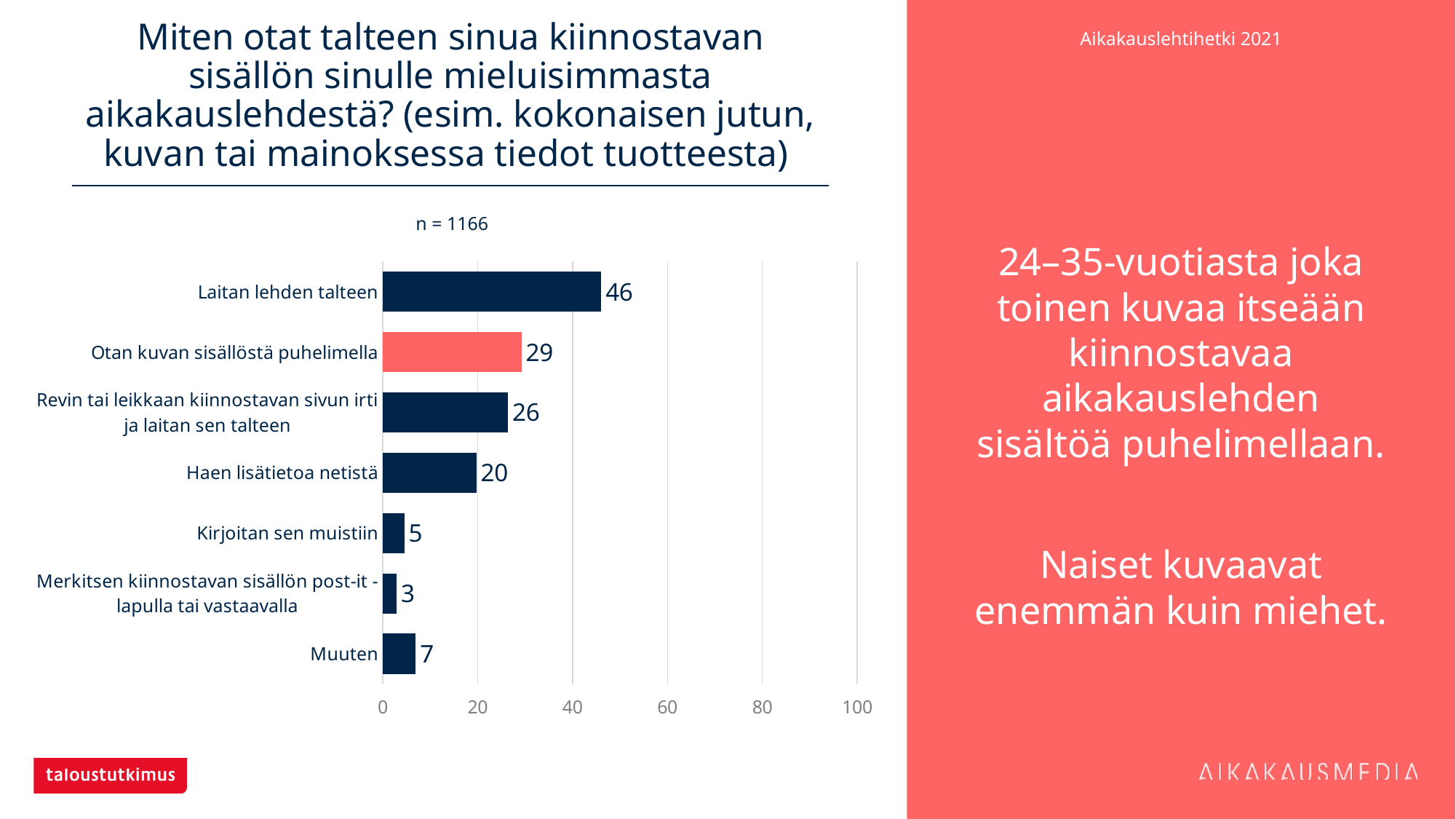
What is the value for "Merkitsen kiinnostavan sisällön post-it -lapulla tai vastaavalla"? 3 What is the value for "Laitan lehden talteen"? 46 What is the value for "Otan kuvan sisällöstä puhelimella"? 29 How many categories are shown in the chart? 7 Which category has the lowest value? Merkitsen kiinnostavan sisällön post-it -lapulla tai vastaavalla What is the difference between the values for "Laitan lehden talteen" and "Otan kuvan sisällöstä puhelimella"? 17 Is the value for "Revin tai leikkaan kiinnostavan sivun irti ja laitan sen talteen" greater or less than 40? less Which is larger: the value for "Kirjoitan sen muistiin" or the value for "Muuten"? Muuten What is the value for "Haen lisätietoa netistä"? 20 Which category has the highest value? Laitan lehden talteen What is the sample size (n) shown above the chart? n = 1166 What kind of chart is shown on the slide? bar chart